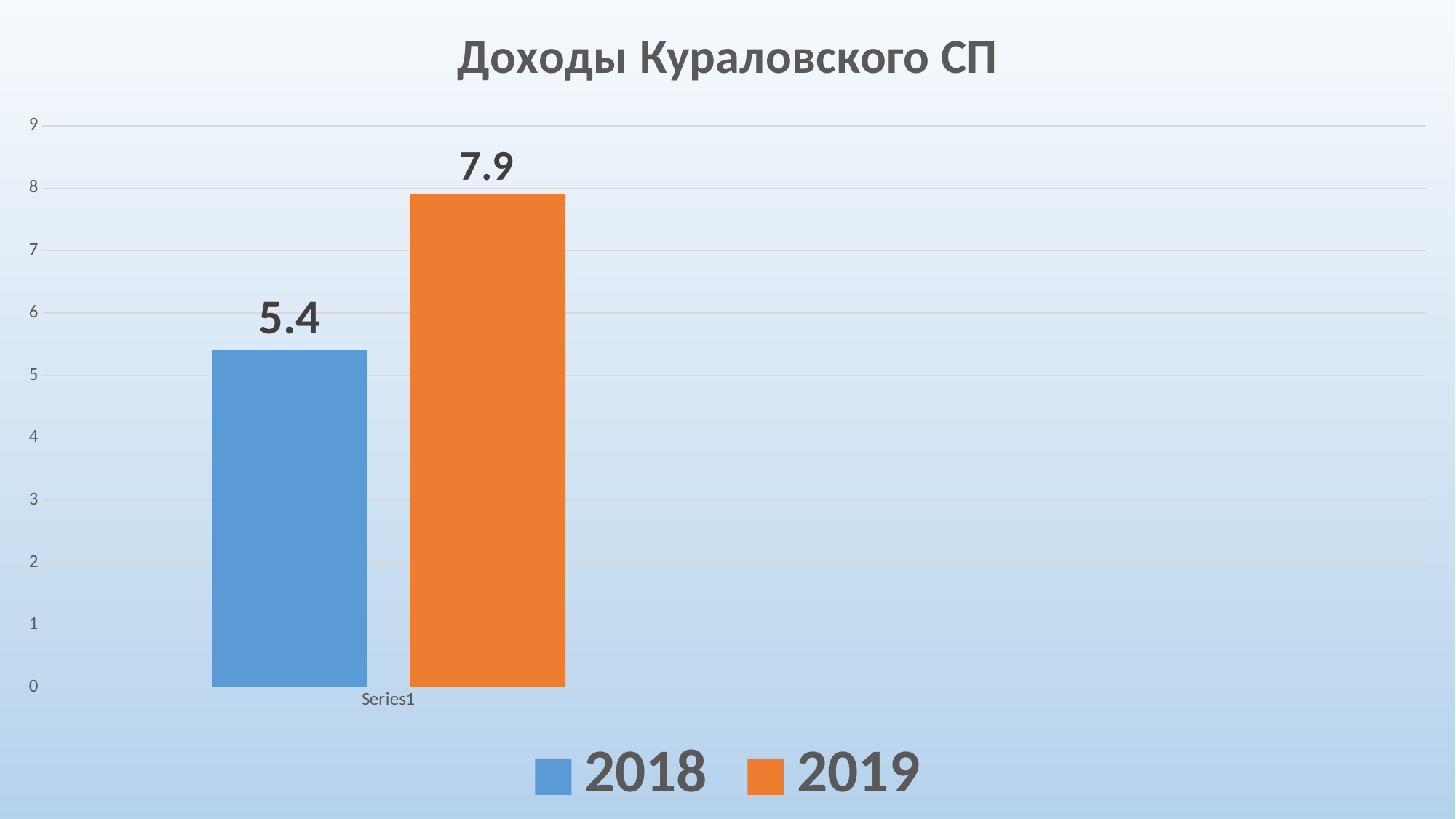
Which series has the lowest value? 2018 Which year has the higher value, 2018 or 2019? 2019 Is the value for 2019 greater or less than 7? greater What kind of chart is shown on the slide? bar chart What is the value for 2019? 7.9 What is the title of the chart? Доходы Кураловского СП Which series has the highest value? 2019 How many series does the legend list? 2 Is the value for 2018 greater or less than 6? less What is the value for 2018? 5.4 What is the difference between the 2019 and 2018 values? 2.5 What colour is the bar for 2019? orange